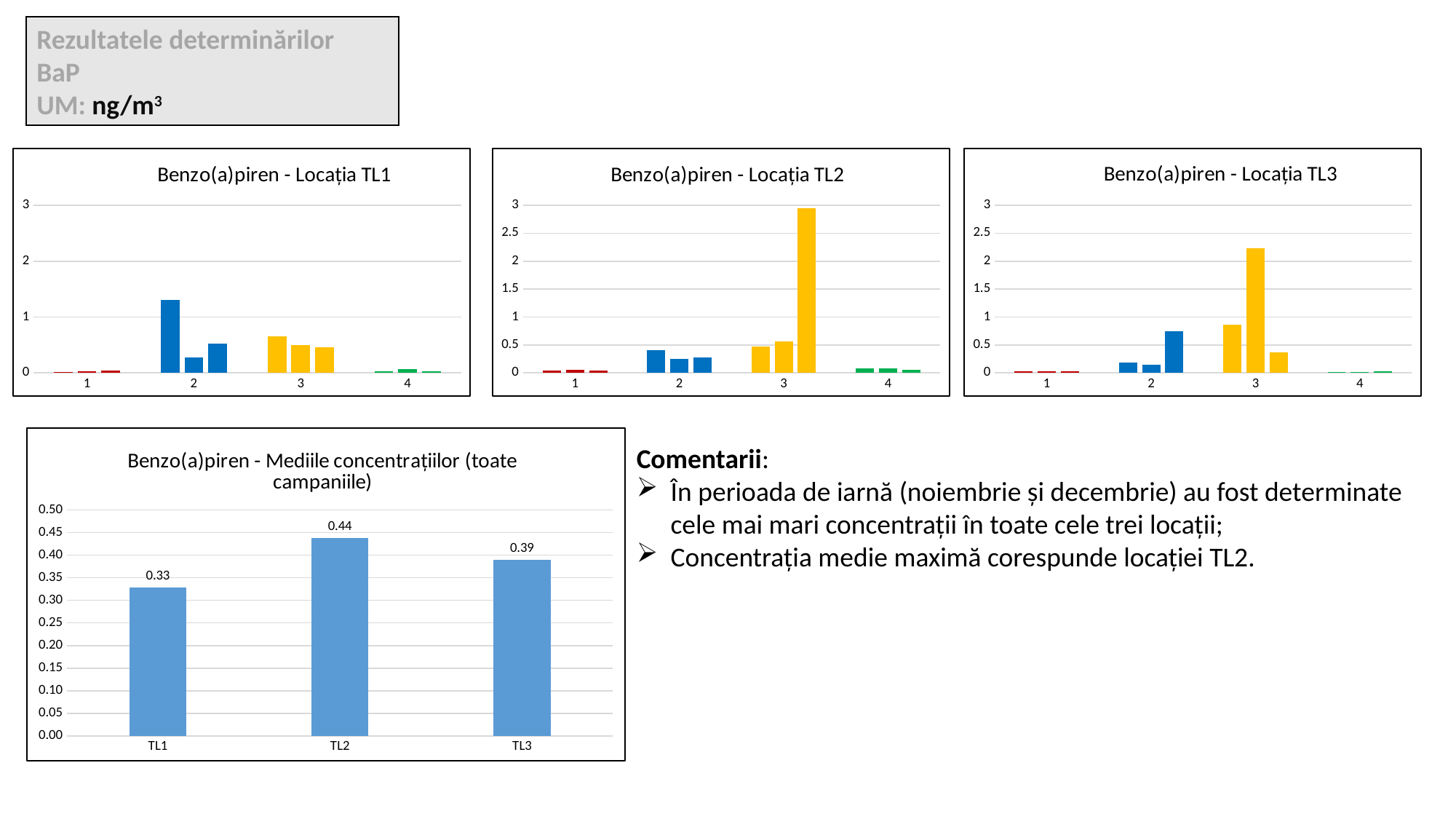
In the chart 'Benzo(a)piren - Mediile concentrațiilor (toate campaniile)', which location has the lowest value? TL1 How many locations are shown in the chart 'Benzo(a)piren - Mediile concentrațiilor (toate campaniile)'? 3 In the chart 'Benzo(a)piren - Mediile concentrațiilor (toate campaniile)', what is the value for TL2? 0.44 In the chart 'Benzo(a)piren - Mediile concentrațiilor (toate campaniile)', what is the difference between the values for TL2 and TL1? 0.11 In the chart 'Benzo(a)piren - Mediile concentrațiilor (toate campaniile)', what is the value for TL3? 0.39 In the chart 'Benzo(a)piren - Mediile concentrațiilor (toate campaniile)', which is larger, the value for TL3 or the value for TL1? TL3 In the chart 'Benzo(a)piren - Mediile concentrațiilor (toate campaniile)', what is the value for TL1? 0.33 In the chart 'Benzo(a)piren - Locația TL3', is the value of the tallest bar in group 3 greater or less than 2? greater In the chart 'Benzo(a)piren - Mediile concentrațiilor (toate campaniile)', which location has the highest value? TL2 In the chart 'Benzo(a)piren - Locația TL2', is the value of the tallest bar in group 3 greater or less than 2.5? greater What kind of chart is 'Benzo(a)piren - Mediile concentrațiilor (toate campaniile)'? bar chart How many groups are shown on the x axis of the chart 'Benzo(a)piren - Locația TL1'? 4